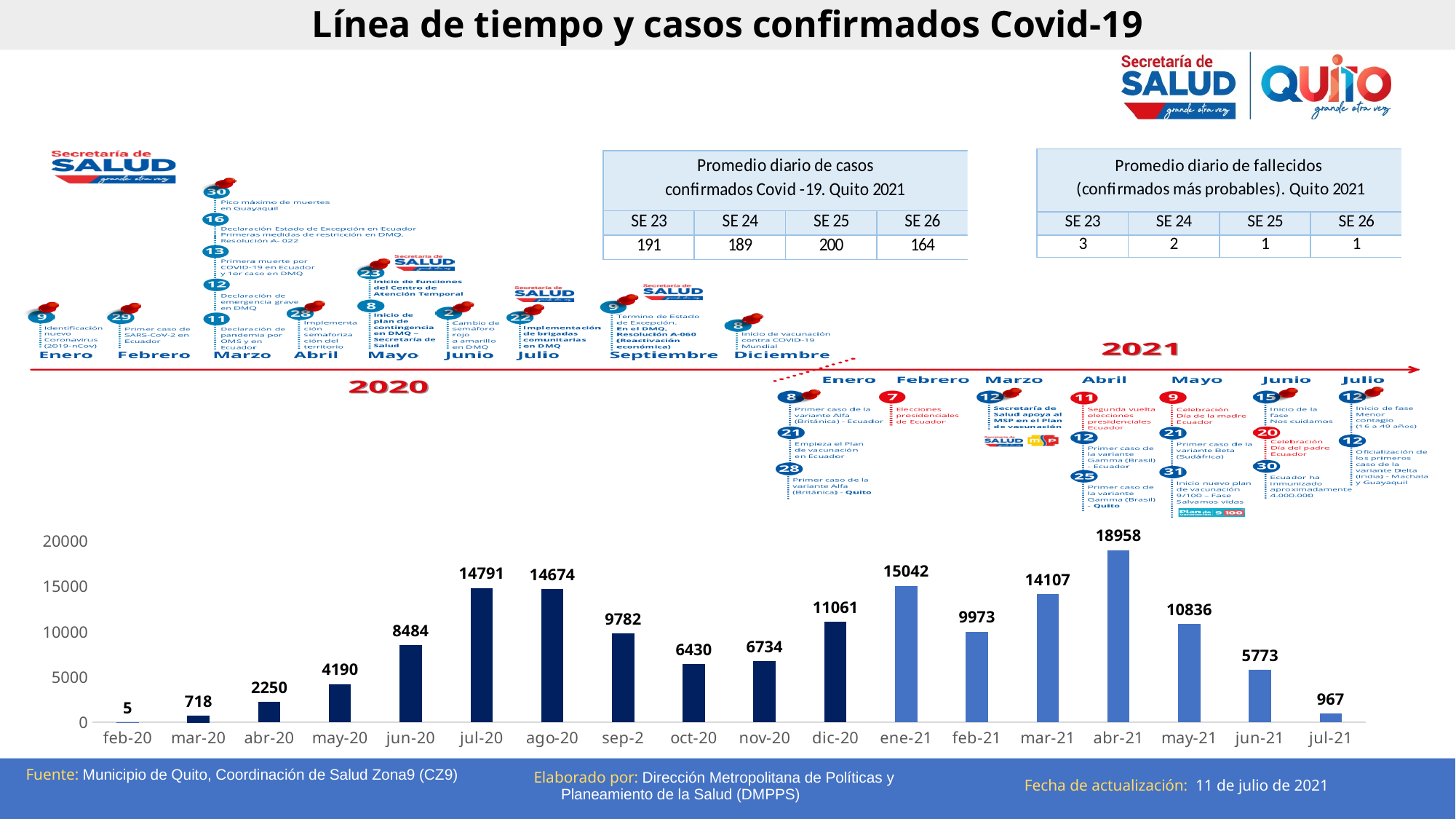
In the bar chart, do the values rise or fall from abr-21 to jul-21? fall How many months (bars) are shown in the bar chart? 18 In the bar chart, what is the value for dic-20? 11061 In the bar chart, what is the value for abr-21? 18958 In the bar chart, what is the difference between the values for jun-21 and jul-21? 4806 Which month has the highest value in the bar chart? abr-21 In the bar chart, which is larger, the value for ene-21 or the value for ago-20? ene-21 Which month has the lowest value in the bar chart? feb-20 In the bar chart, what is the value for feb-20? 5 In the bar chart, what is the value for jul-20? 14791 What type of chart is shown at the bottom of the slide? bar chart In the bar chart, what is the difference between the values for abr-21 and mar-21? 4851